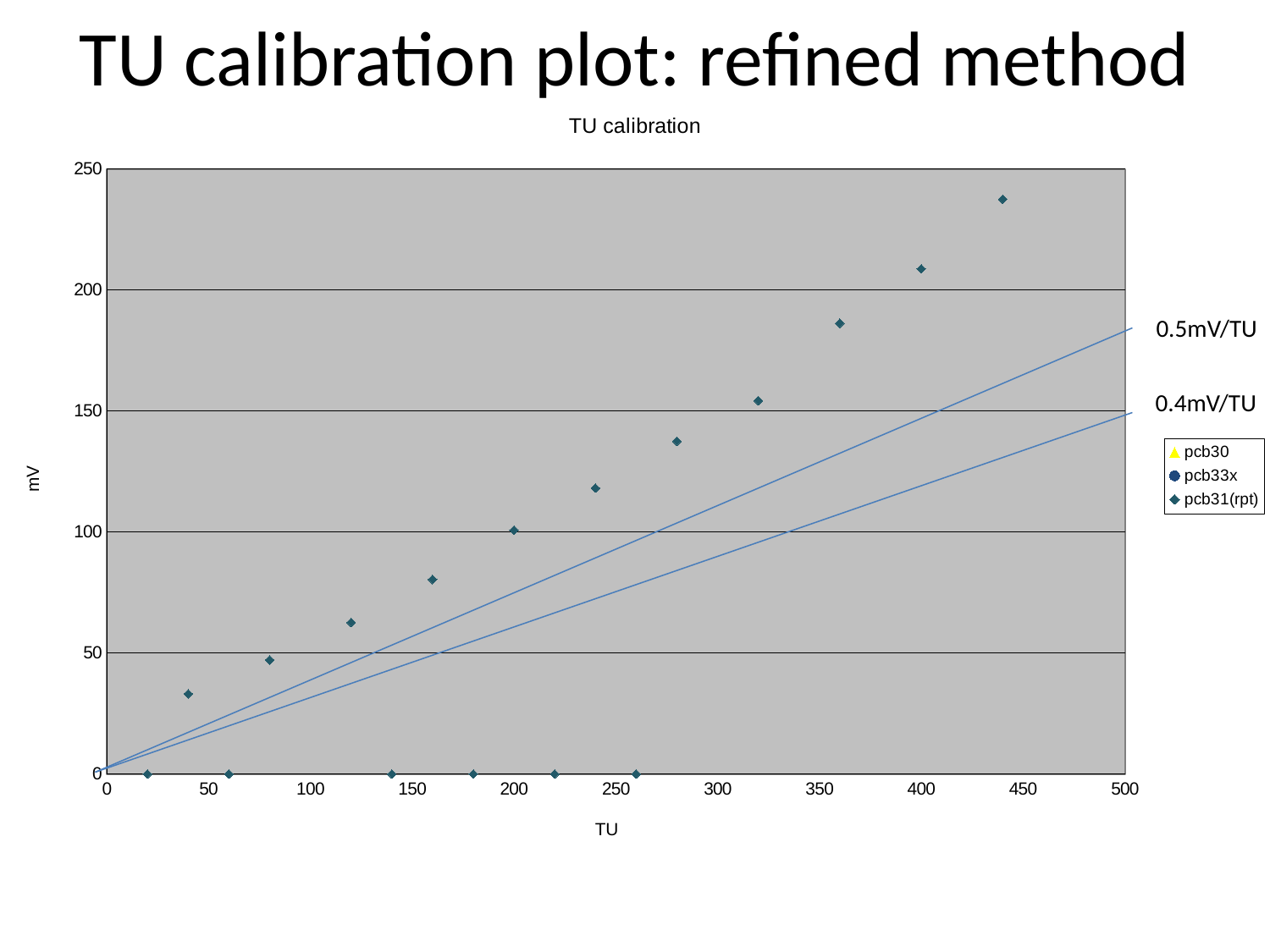
Is the mV value of the plotted point at TU = 120 greater or less than 50? greater What kind of chart is shown on the slide? scatter chart Is the mV value of the plotted point at TU = 360 greater or less than 150? greater Is the mV value of the plotted point at TU = 280 greater or less than 150? less How many series does the chart legend list? 3 Which of the two reference lines is steeper, the one labelled 0.5mV/TU or the one labelled 0.4mV/TU? 0.5mV/TU Do the mV values of the diamond data points rise or fall as TU increases? rise What label is on the vertical axis of the chart? mV What is the title of the chart? TU calibration At which TU value does the highest mV data point occur? 440